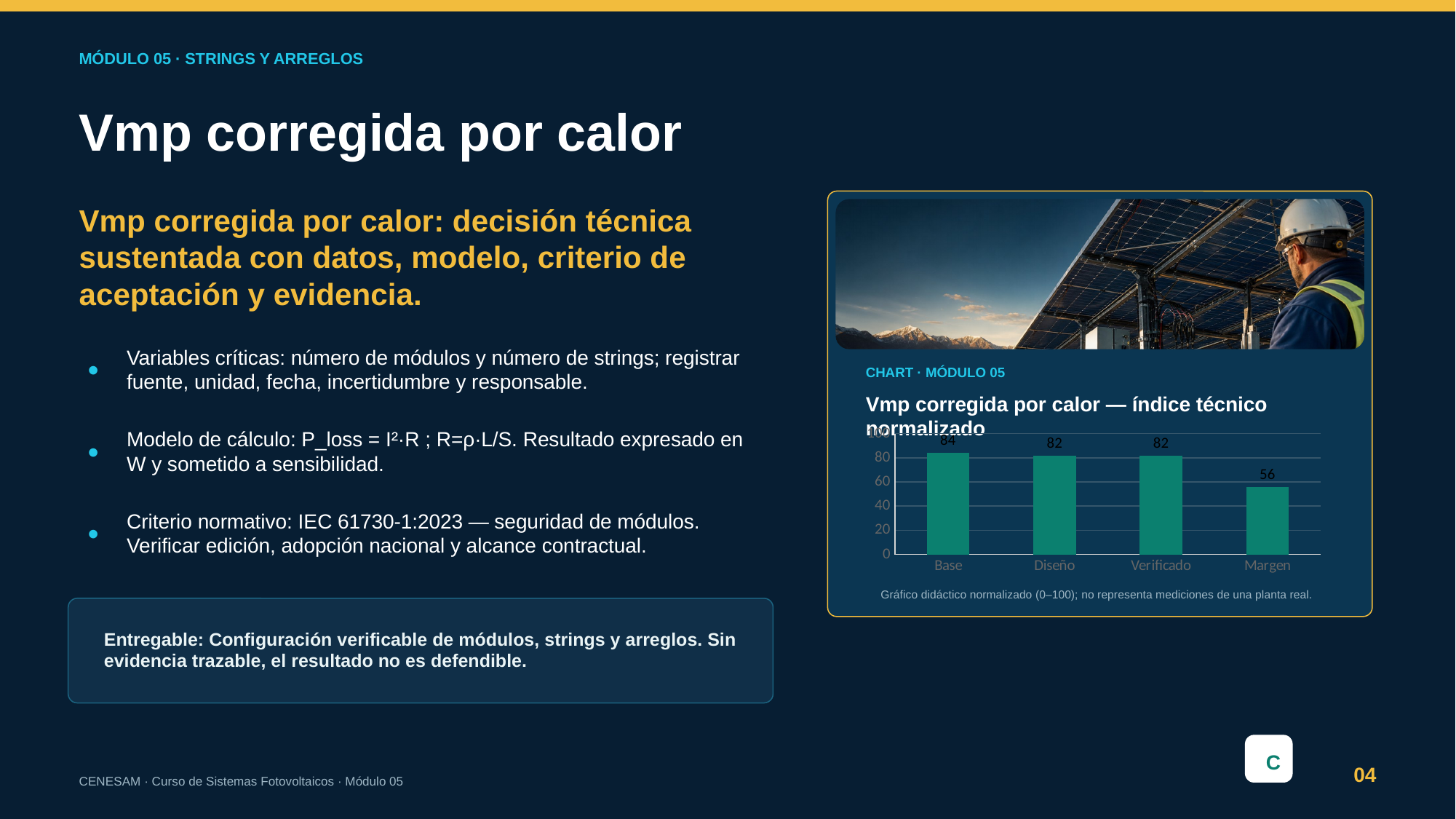
What is the value for Margen? 56 What is the title of the chart? Vmp corregida por calor — índice técnico normalizado How many categories are shown on the x axis? 4 What kind of chart is shown? Bar chart What is the value for Diseño? 82 Which category has the lowest value? Margen Which category has the highest value? Base Which is larger, the value for Diseño or the value for Margen? Diseño Is the value for Margen greater or less than 60? less What is the difference between the values for Verificado and Margen? 26 What is the difference between the values for Base and Margen? 28 What is the value for Base? 84